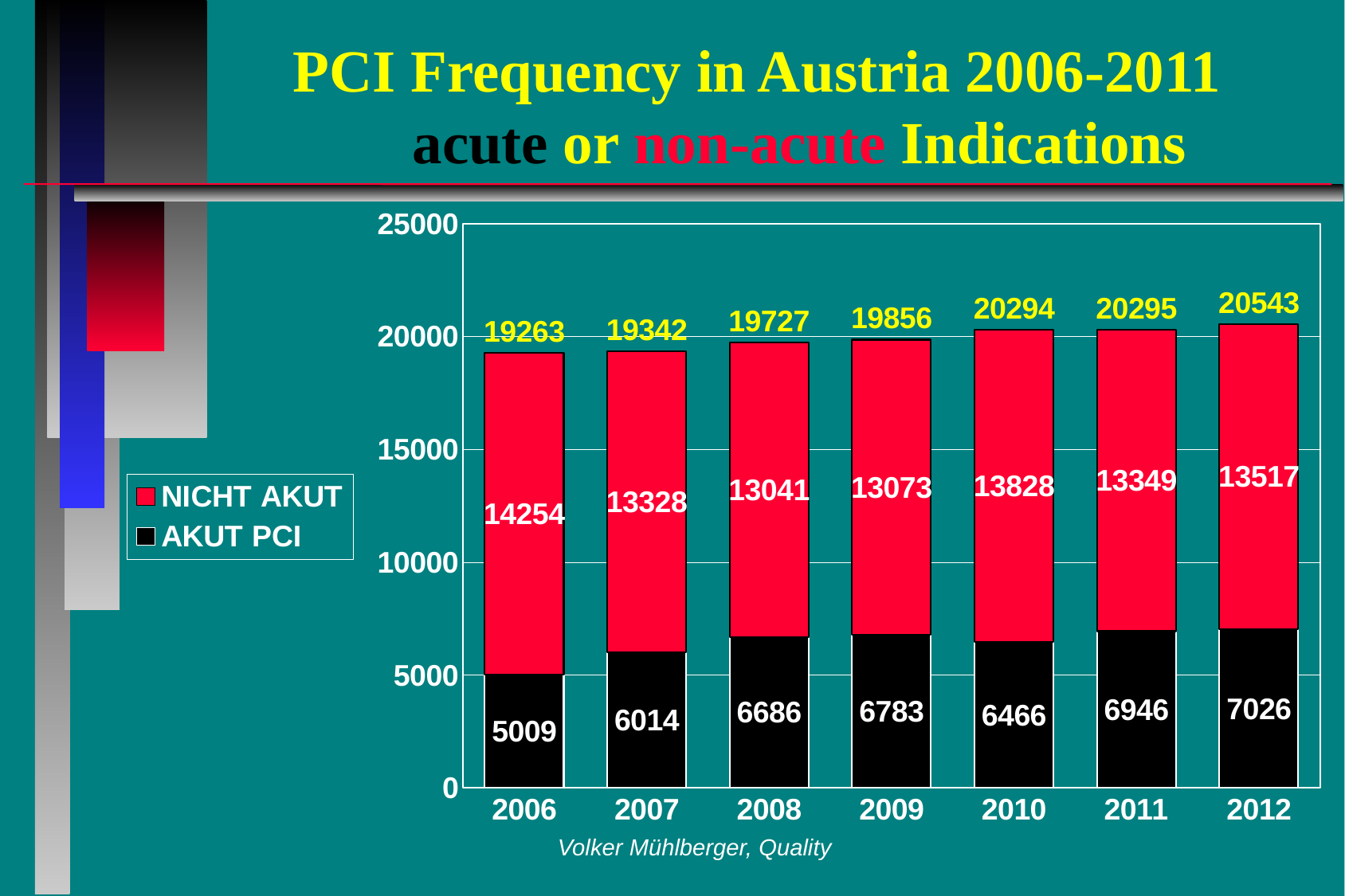
What kind of chart is shown on the slide? Stacked bar chart What is the AKUT PCI value for 2006? 5009 Which colour represents AKUT PCI in the legend? Black What is the NICHT AKUT value for 2010? 13828 Which year has the highest AKUT PCI value? 2012 How many series does the legend list? 2 How many years are shown on the x axis? 7 Which is larger, the NICHT AKUT value for 2011 or for 2012? 2012 Do the total values above the bars rise or fall from 2006 to 2012? Rise Which year has the lowest NICHT AKUT value? 2008 What is the total PCI count shown above the bar for 2012? 20543 What is the difference between the AKUT PCI values for 2007 and 2006? 1005